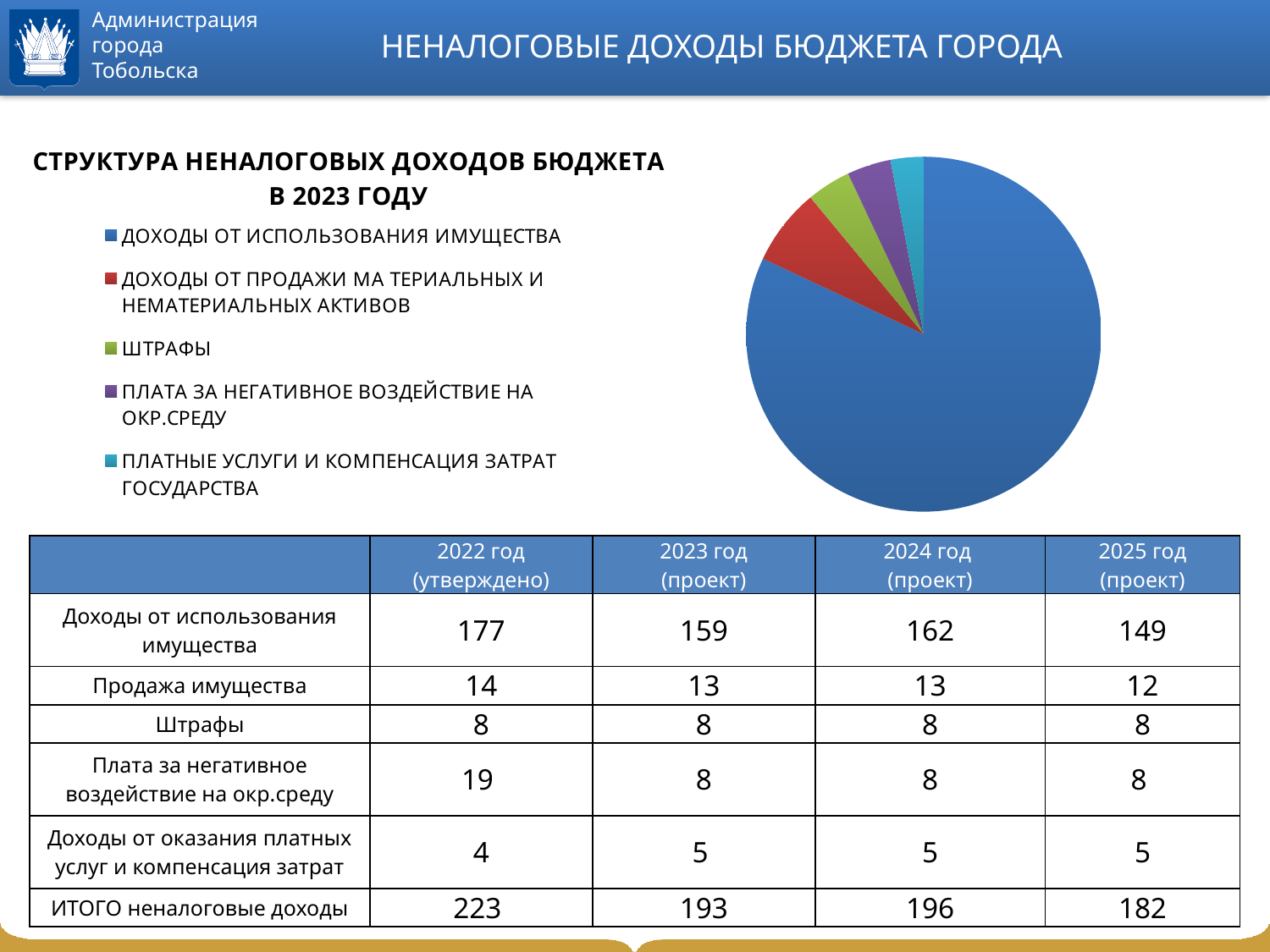
What colour is the slice for ШТРАФЫ in the pie chart? green Which slice is larger in the pie chart: ДОХОДЫ ОТ ИСПОЛЬЗОВАНИЯ ИМУЩЕСТВА or ДОХОДЫ ОТ ПРОДАЖИ МАТЕРИАЛЬНЫХ И НЕМАТЕРИАЛЬНЫХ АКТИВОВ? ДОХОДЫ ОТ ИСПОЛЬЗОВАНИЯ ИМУЩЕСТВА Which year does the pie chart describe? 2023 What is the title of the pie chart? СТРУКТУРА НЕНАЛОГОВЫХ ДОХОДОВ БЮДЖЕТА В 2023 ГОДУ Which category has the largest slice in the pie chart? ДОХОДЫ ОТ ИСПОЛЬЗОВАНИЯ ИМУЩЕСТВА Which category has the smallest slice in the pie chart? ПЛАТНЫЕ УСЛУГИ И КОМПЕНСАЦИЯ ЗАТРАТ ГОСУДАРСТВА Which slice is larger in the pie chart: ДОХОДЫ ОТ ПРОДАЖИ МАТЕРИАЛЬНЫХ И НЕМАТЕРИАЛЬНЫХ АКТИВОВ or ШТРАФЫ? ДОХОДЫ ОТ ПРОДАЖИ МАТЕРИАЛЬНЫХ И НЕМАТЕРИАЛЬНЫХ АКТИВОВ How many entries does the legend of the pie chart list? 5 How many slices does the pie chart have? 5 What kind of chart is shown on the slide? pie chart